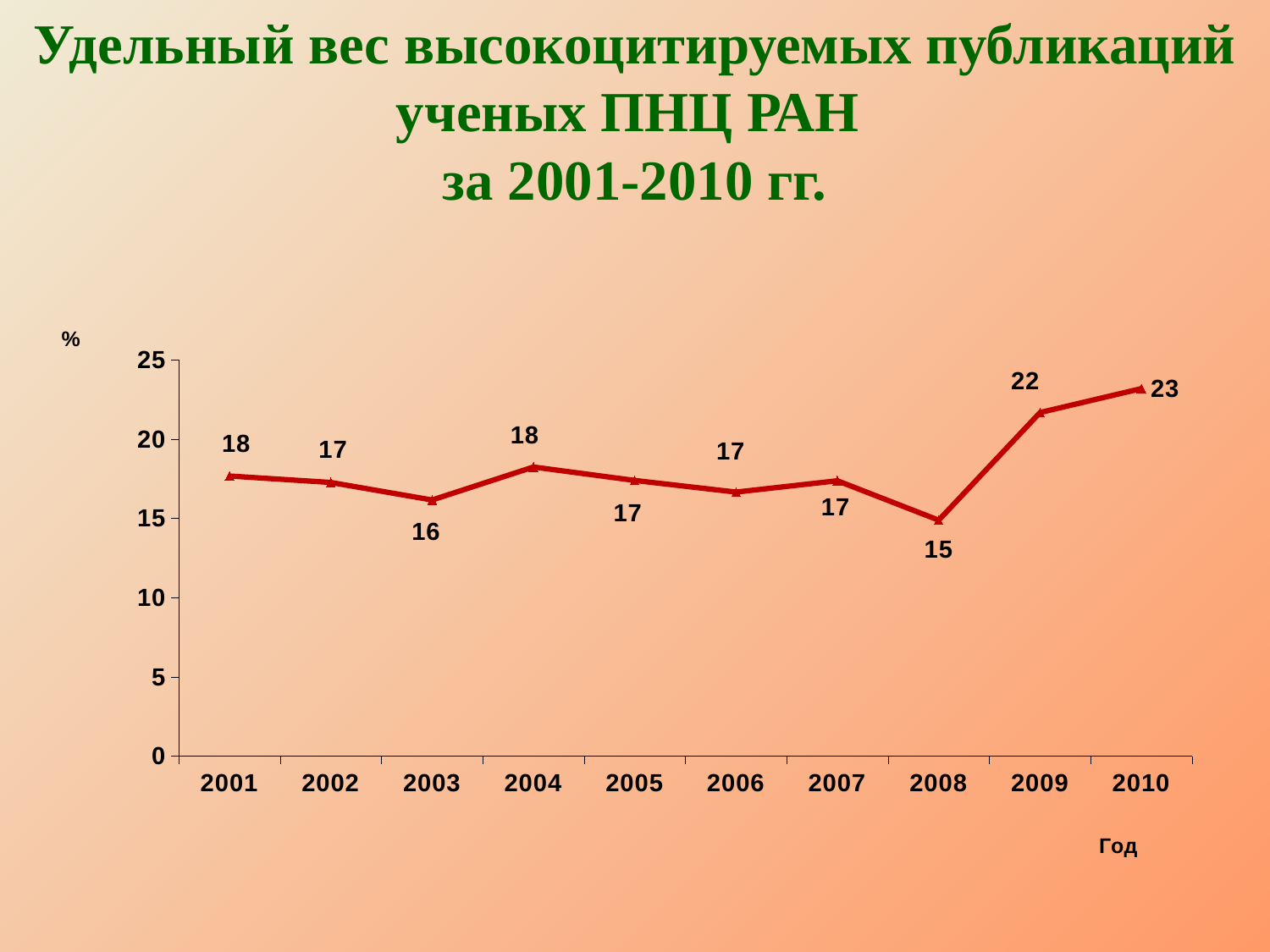
What is the difference between the values for 2010 and 2008? 8 Which year has the highest value? 2010 What is the value for 2008? 15 How many years are plotted on the x axis? 10 Do the values rise or fall from 2008 to 2010? rise Which is larger, the value for 2009 or the value for 2004? 2009 What is the value for 2001? 18 Which year has the lowest value? 2008 What is the value for 2010? 23 What is the value for 2003? 16 What kind of chart is shown on the slide? line chart Is the value for 2009 greater or less than 20? greater